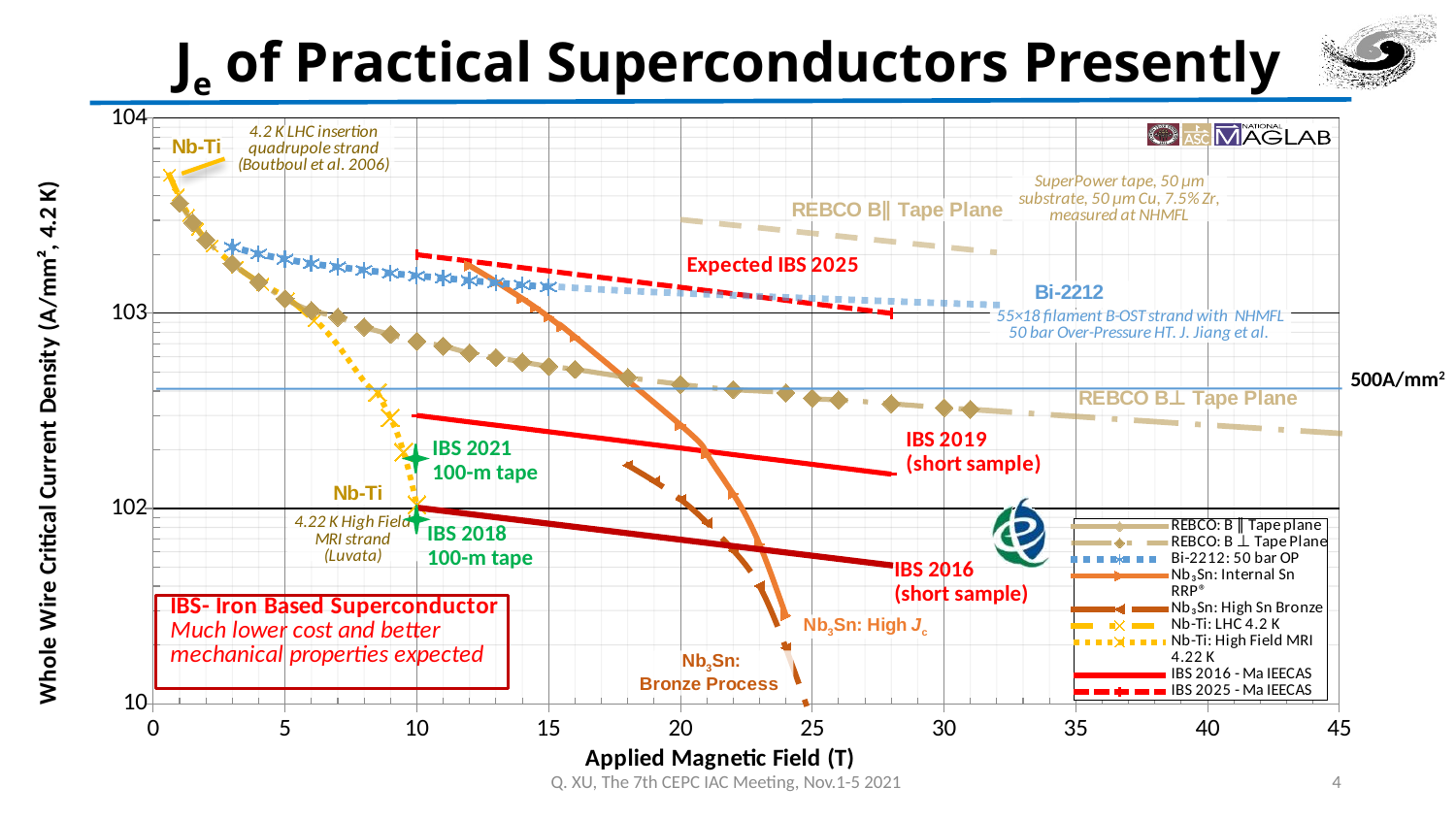
Is the value for Expected IBS 2025 at 15 T greater or less than 10^3 A/mm²? greater Is the value for Bi-2212 at 20 T greater or less than 10^3 A/mm²? greater Is the value for IBS 2016 (short sample) at 25 T greater or less than 10^2 A/mm²? less At 20 T, which series has the higher value: Bi-2212 or Nb3Sn Internal Sn RRP? Bi-2212 What is the largest value shown on the x axis of the chart? 45 What is the label of the x axis of the chart? Applied Magnetic Field (T) What value is marked by the horizontal reference line labelled on the right side of the chart? 500A/mm² What kind of chart is shown on the slide? line chart At 10 T, which series has the higher value: Nb-Ti LHC 4.2 K or Nb-Ti High Field MRI 4.22 K? Nb-Ti LHC 4.2 K Do the plotted current density values generally rise or fall as the applied magnetic field increases? fall How many series does the chart legend list? 9